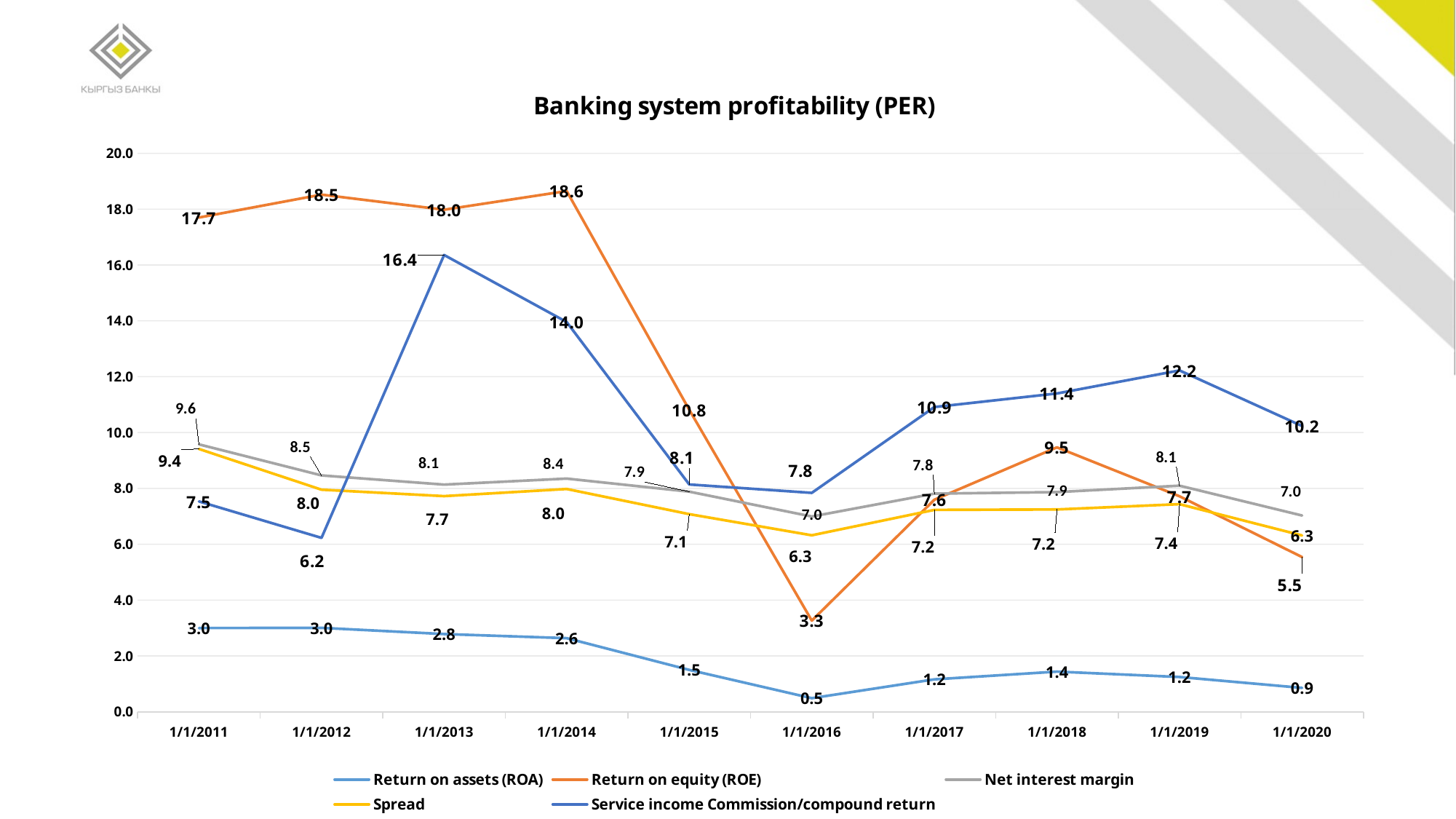
How many dates are shown on the x axis? 10 What is the difference between the Return on equity (ROE) values on 1/1/2014 and 1/1/2016? 15.3 Does Return on assets (ROA) rise or fall from 1/1/2011 to 1/1/2016? Fall What is the Service income Commission/compound return value on 1/1/2013? 16.4 Which is larger on 1/1/2019: Service income Commission/compound return or Return on equity (ROE)? Service income Commission/compound return In which year does Return on equity (ROE) reach its highest value? 1/1/2014 In which year is Return on equity (ROE) at its lowest? 1/1/2016 How many series does the legend list? 5 What is the Return on assets (ROA) value on 1/1/2016? 0.5 Is the Return on equity (ROE) value on 1/1/2012 greater or less than 16.0? greater What kind of chart is shown on the slide? Line chart What is the Return on equity (ROE) value on 1/1/2014? 18.6